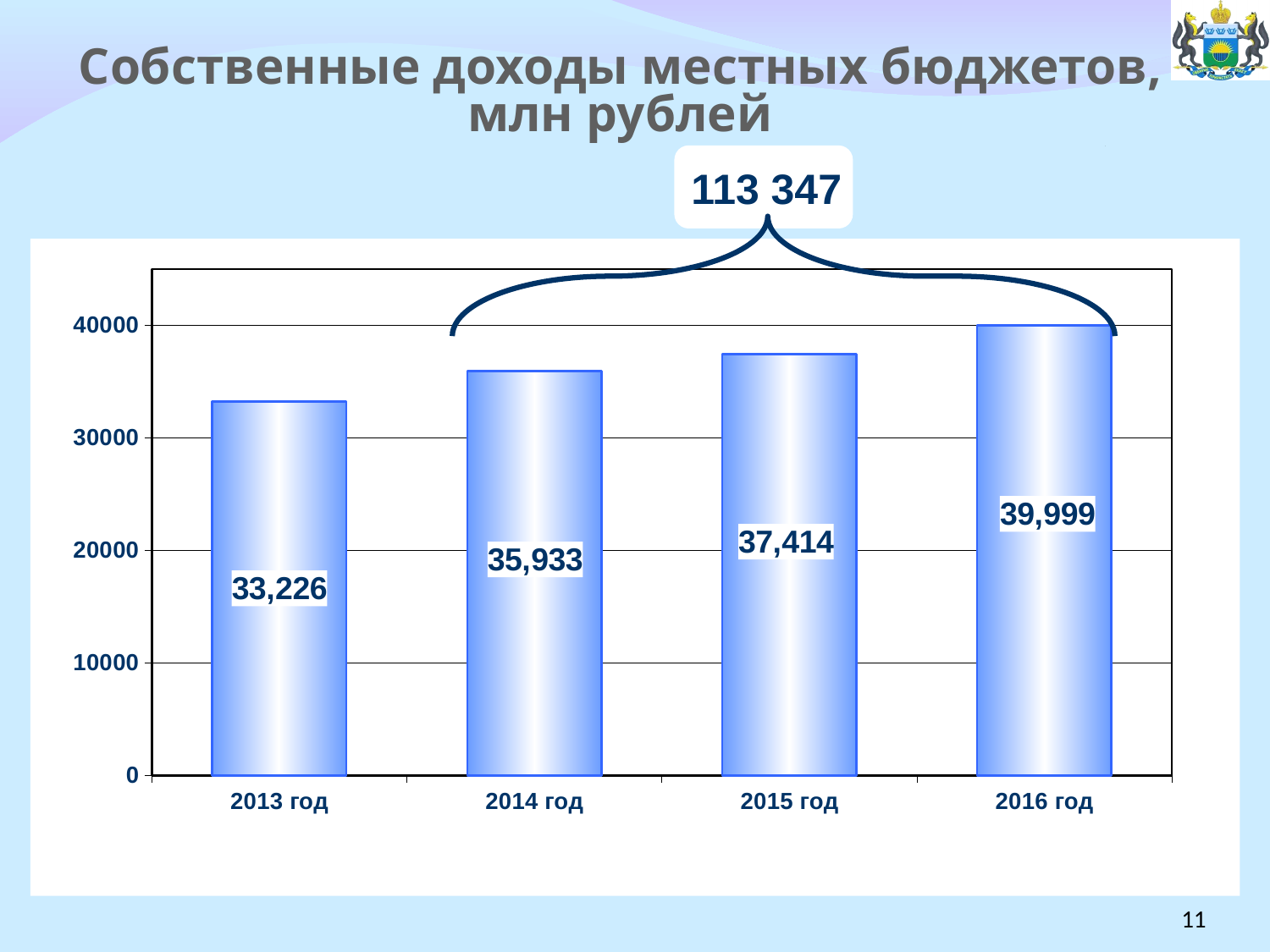
What is the difference between the values for 2015 год and 2014 год? 1,481 Which year has the lowest value? 2013 год What is the value for 2016 год? 39,999 Which is larger, the value for 2014 год or the value for 2015 год? 2015 год Which year has the highest value? 2016 год What is the value for 2015 год? 37,414 What is the difference between the values for 2016 год and 2013 год? 6,773 What is the value for 2013 год? 33,226 What kind of chart is shown on the slide? Bar chart Do the values rise or fall from 2013 год to 2016 год? Rise How many bars are shown in the chart? 4 What number is shown in the callout above the brace spanning 2014–2016? 113 347